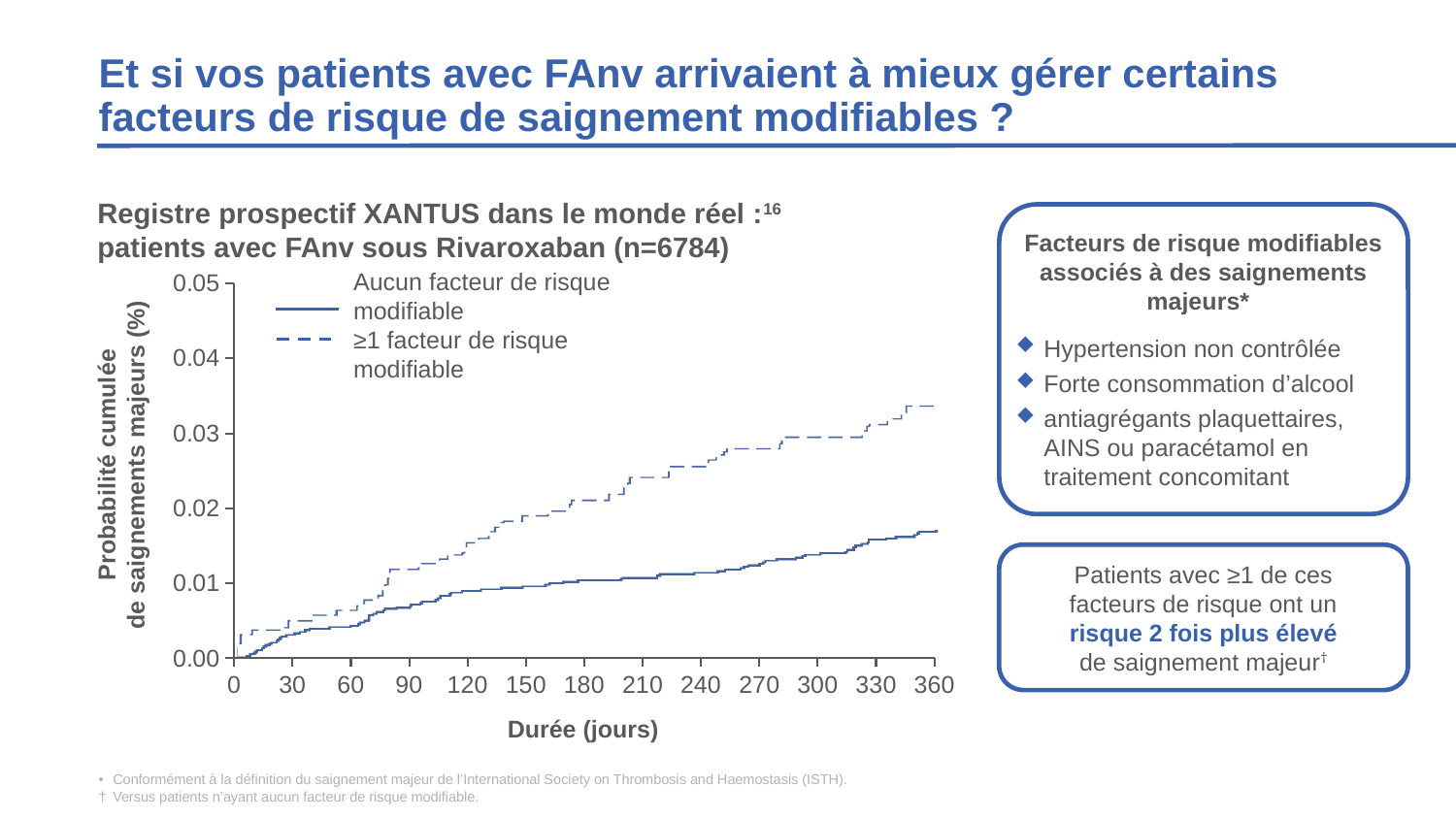
Which series has the lower cumulative probability of major bleeding at 240 days? Aucun facteur de risque modifiable What is the label of the x axis? Durée (jours) Is the value for the 'Aucun facteur de risque modifiable' series at 90 days greater or less than 0.01? less How many tick marks are labelled on the x axis (Durée (jours))? 13 Which series has the higher cumulative probability of major bleeding at 360 days? ≥1 facteur de risque modifiable Which series is drawn with a dashed line? ≥1 facteur de risque modifiable What kind of chart is shown on the slide? line chart Is the value for the '≥1 facteur de risque modifiable' series at 360 days greater or less than 0.03? greater Is the value for the 'Aucun facteur de risque modifiable' series at 360 days greater or less than 0.02? less How many series does the chart's legend list? 2 Do the curves rise or fall as the duration in days increases? rise